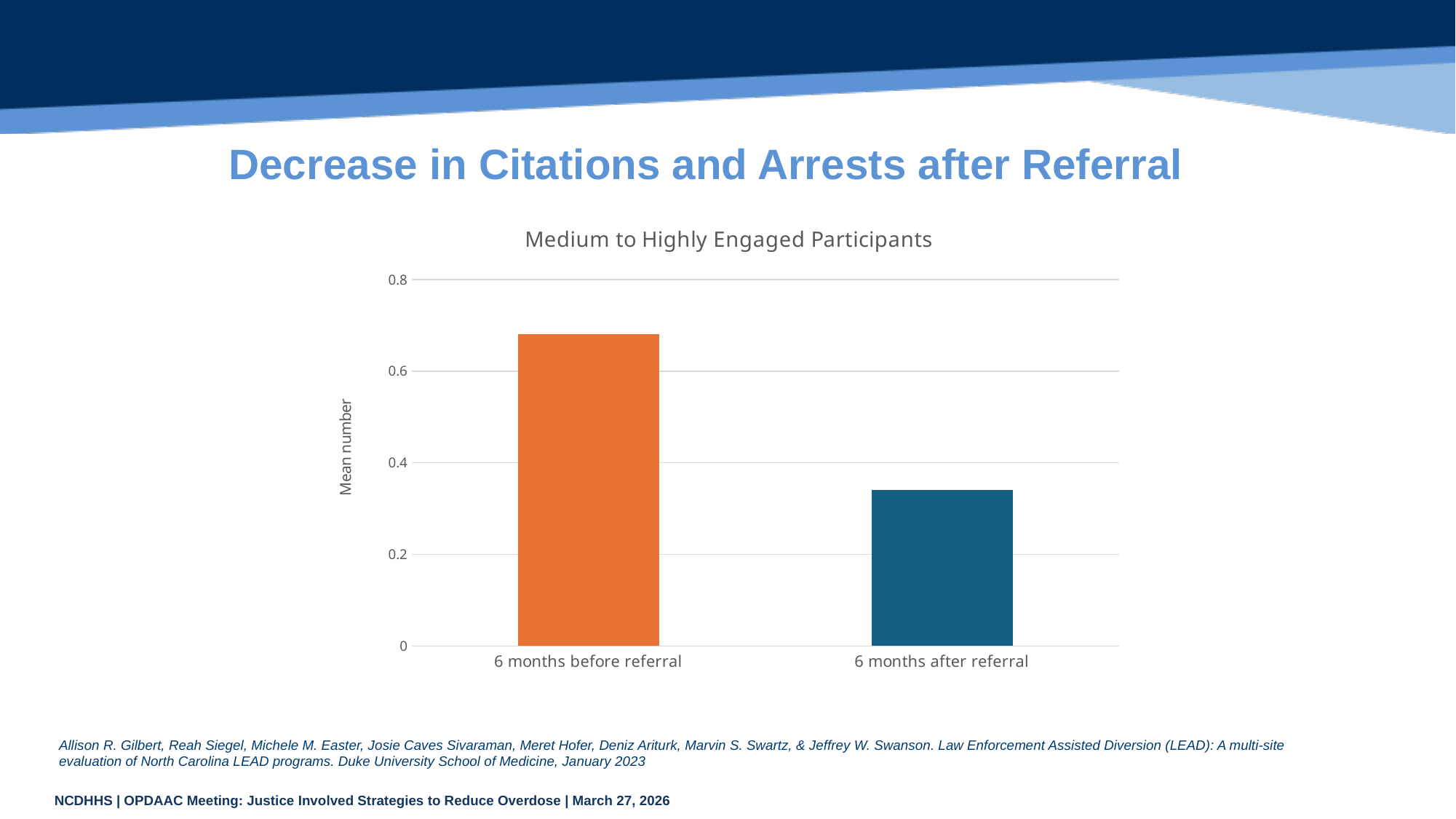
What is the label on the vertical axis? Mean number What kind of chart is shown on the slide? bar chart Is the value for 6 months before referral greater or less than 0.6? greater Is the value for 6 months after referral greater or less than 0.2? greater Do the values rise or fall from left to right along the x axis? fall Is the value for 6 months after referral greater or less than 0.4? less Which category has the lowest value? 6 months after referral Which category has the highest value? 6 months before referral What is the title of the chart? Medium to Highly Engaged Participants How many categories are plotted on the x axis? 2 Which is larger, the value for 6 months before referral or 6 months after referral? 6 months before referral